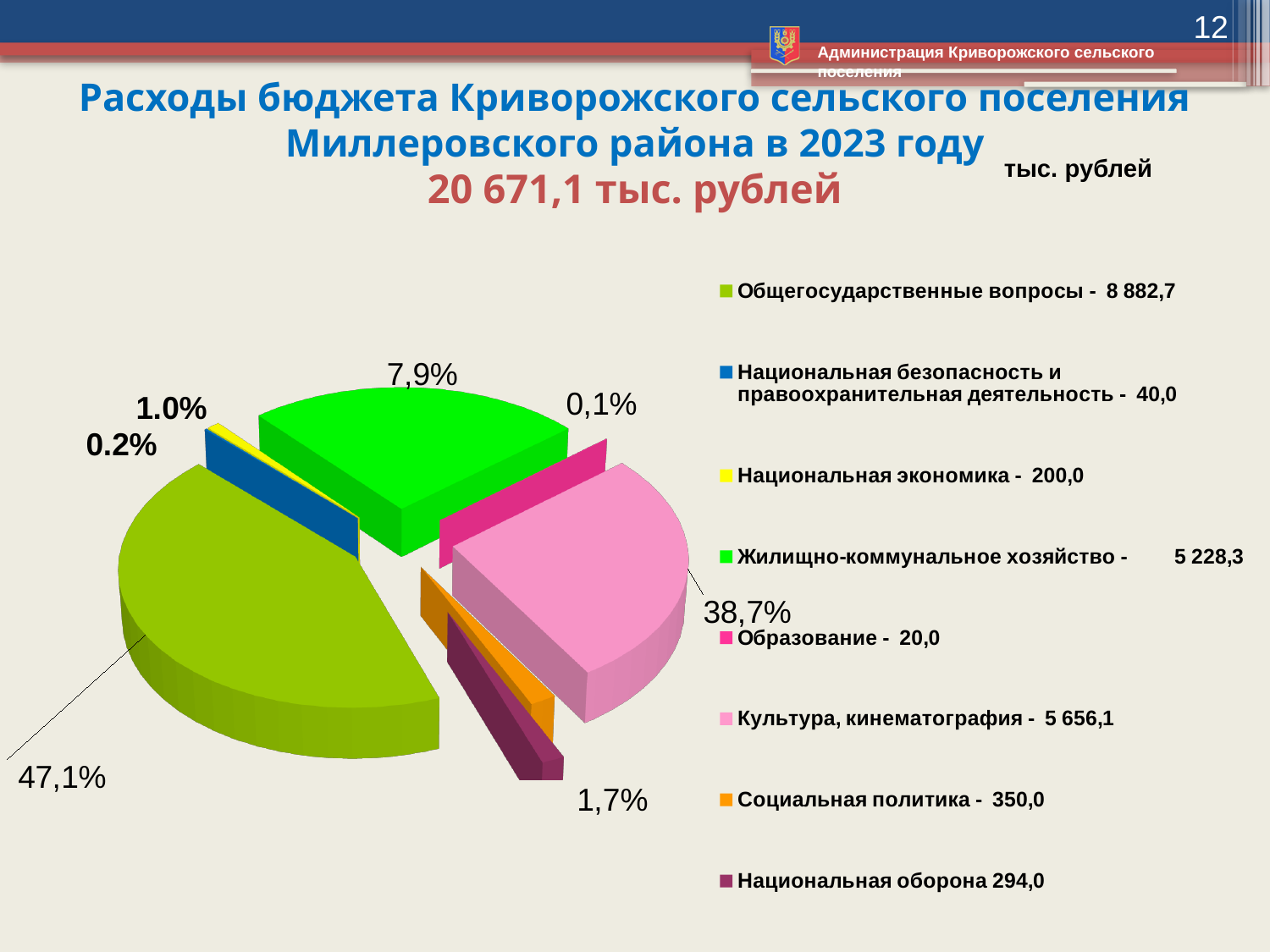
What is the value for Социальная политика according to the legend? 350,0 Which category has the smallest value in the pie chart? Образование What is the difference between the values for Общегосударственные вопросы and Культура, кинематография? 3 226,6 What is the value for Культура, кинематография according to the legend? 5 656,1 How many categories does the legend of the pie chart list? 8 Which is larger: the value for Культура, кинематография or for Жилищно-коммунальное хозяйство? Культура, кинематография What is the value for Общегосударственные вопросы according to the legend? 8 882,7 Which category has the largest value in the pie chart? Общегосударственные вопросы What percentage share is labelled on the slice for Общегосударственные вопросы? 47,1% What is the value for Национальная оборона according to the legend? 294,0 What total budget expenditure is stated in the chart title? 20 671,1 тыс. рублей What kind of chart is shown on the slide? pie chart